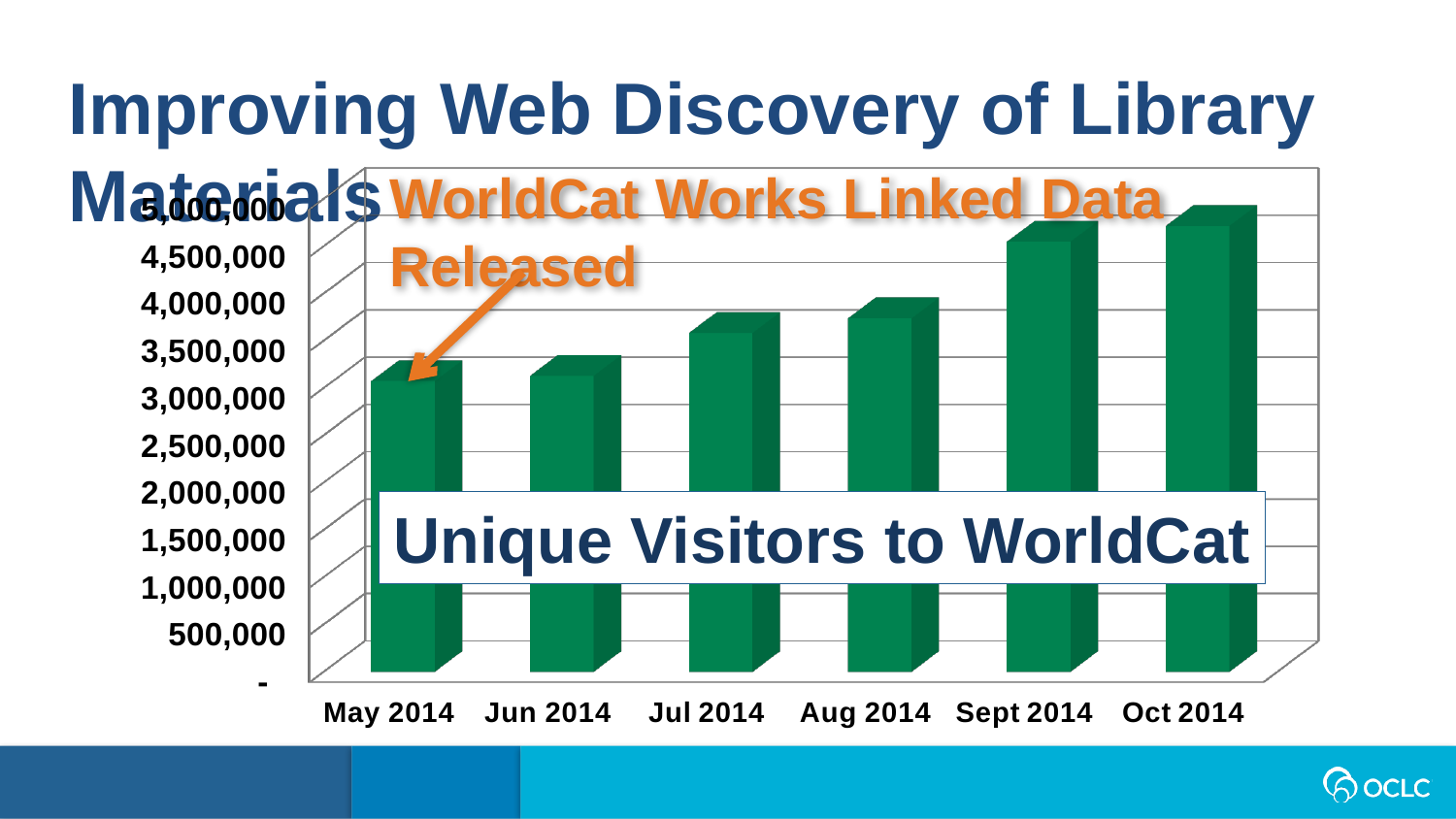
What is the title shown on the chart? Unique Visitors to WorldCat Which month does the annotation "WorldCat Works Linked Data Released" point to? May 2014 Is the value for May 2014 greater or less than 3,500,000? less Is the value for Jul 2014 greater or less than 4,000,000? less Is the value for Jun 2014 greater or less than 3,000,000? greater Do the unique visitor values generally rise or fall from May 2014 to Oct 2014? rise What kind of chart is shown on the slide? bar chart Which month has more unique visitors, Jul 2014 or Sept 2014? Sept 2014 Which month has the highest number of unique visitors to WorldCat? Oct 2014 How many months are plotted on the x axis of the chart? 6